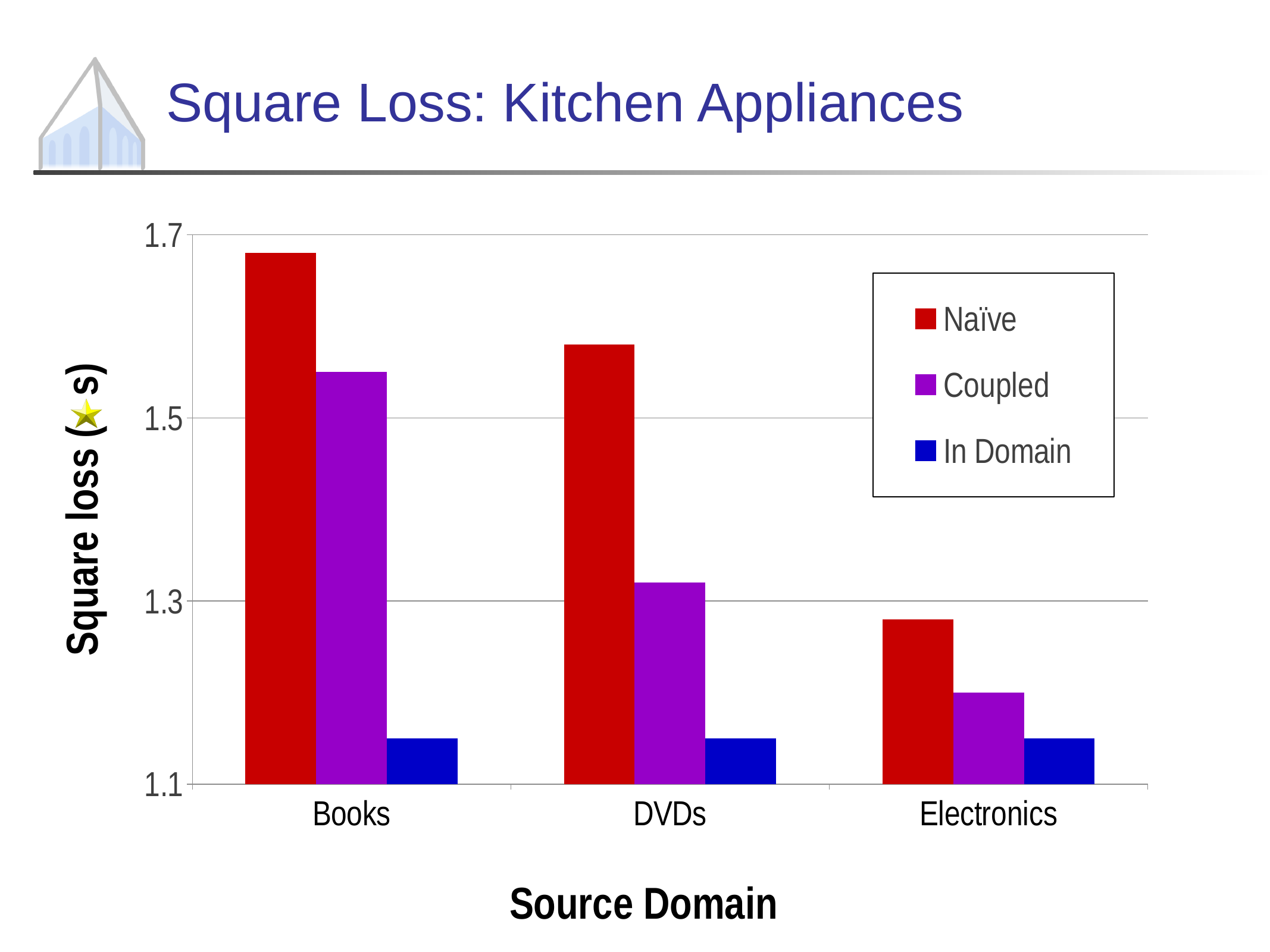
Is the Coupled square loss for Electronics greater or less than 1.3? less Which source domain has the lowest Coupled square loss? Electronics Is the Naïve square loss for DVDs greater or less than 1.5? greater Which source domain has the highest Naïve square loss? Books How many series does the legend list? 3 What kind of chart is shown on the slide? bar chart For DVDs, which is larger: the Naïve square loss or the Coupled square loss? Naïve What is the label of the x axis? Source Domain How many source domain categories are shown on the x axis? 3 Is the Naïve square loss for Books greater or less than 1.5? greater Does the Naïve square loss rise or fall moving from Books to Electronics along the x axis? fall Which source domain has the lowest Naïve square loss? Electronics